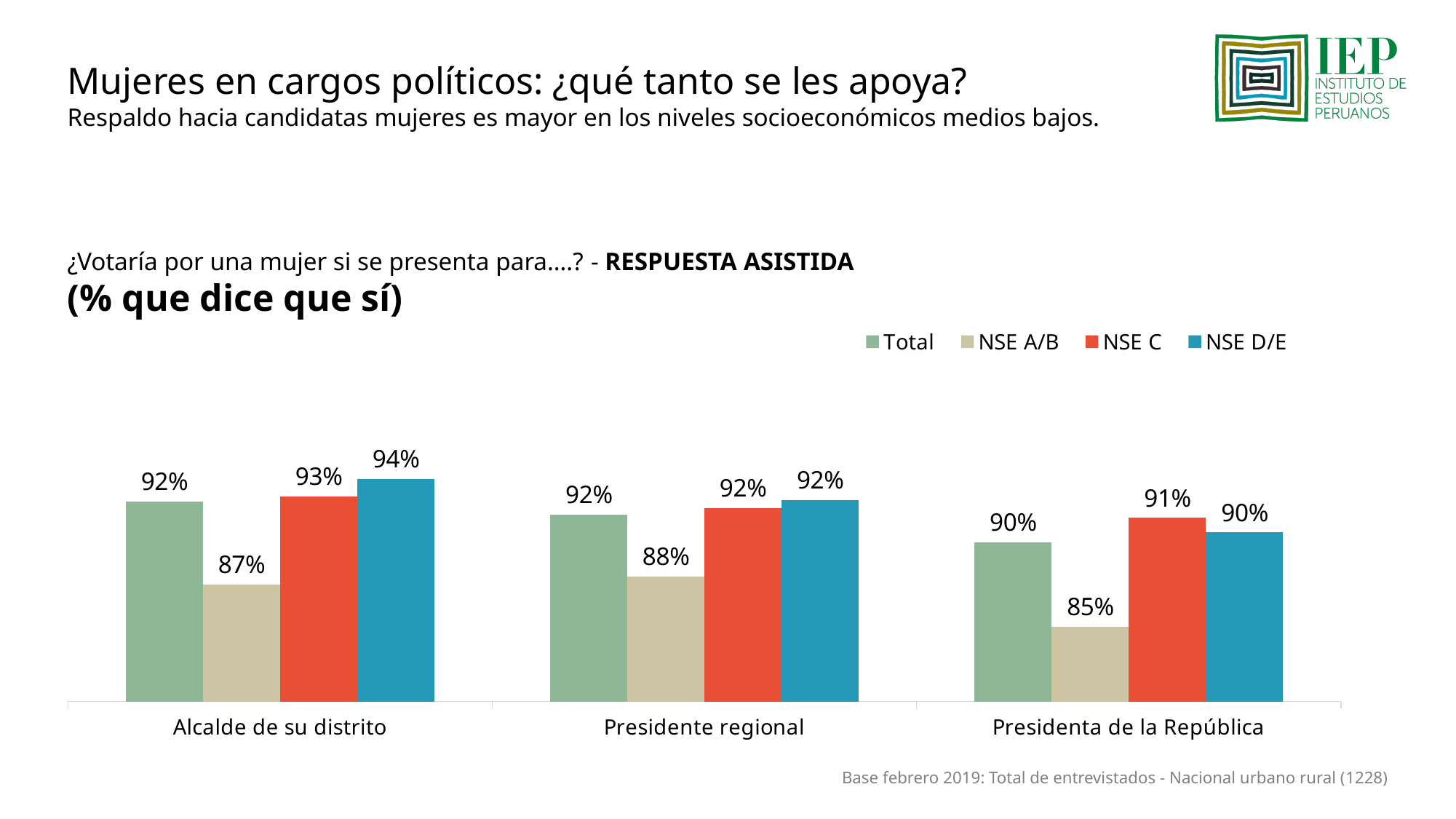
What kind of chart is shown on the slide? Bar chart How many series does the legend list? 4 What is the value for NSE A/B for Presidenta de la República? 85% Which colour represents NSE C in the legend? Red Which series has the highest value for Alcalde de su distrito? NSE D/E How many categories are shown on the x axis? 3 What is the Total value for Presidente regional? 92% What is the value for NSE D/E for Alcalde de su distrito? 94% What is the difference between the NSE D/E and NSE A/B values for Alcalde de su distrito? 7 percentage points Which is larger: the NSE C value for Presidenta de la República or the NSE A/B value for Presidenta de la República? NSE C What is the value for NSE C for Presidenta de la República? 91% Which series has the lowest value for Presidente regional? NSE A/B